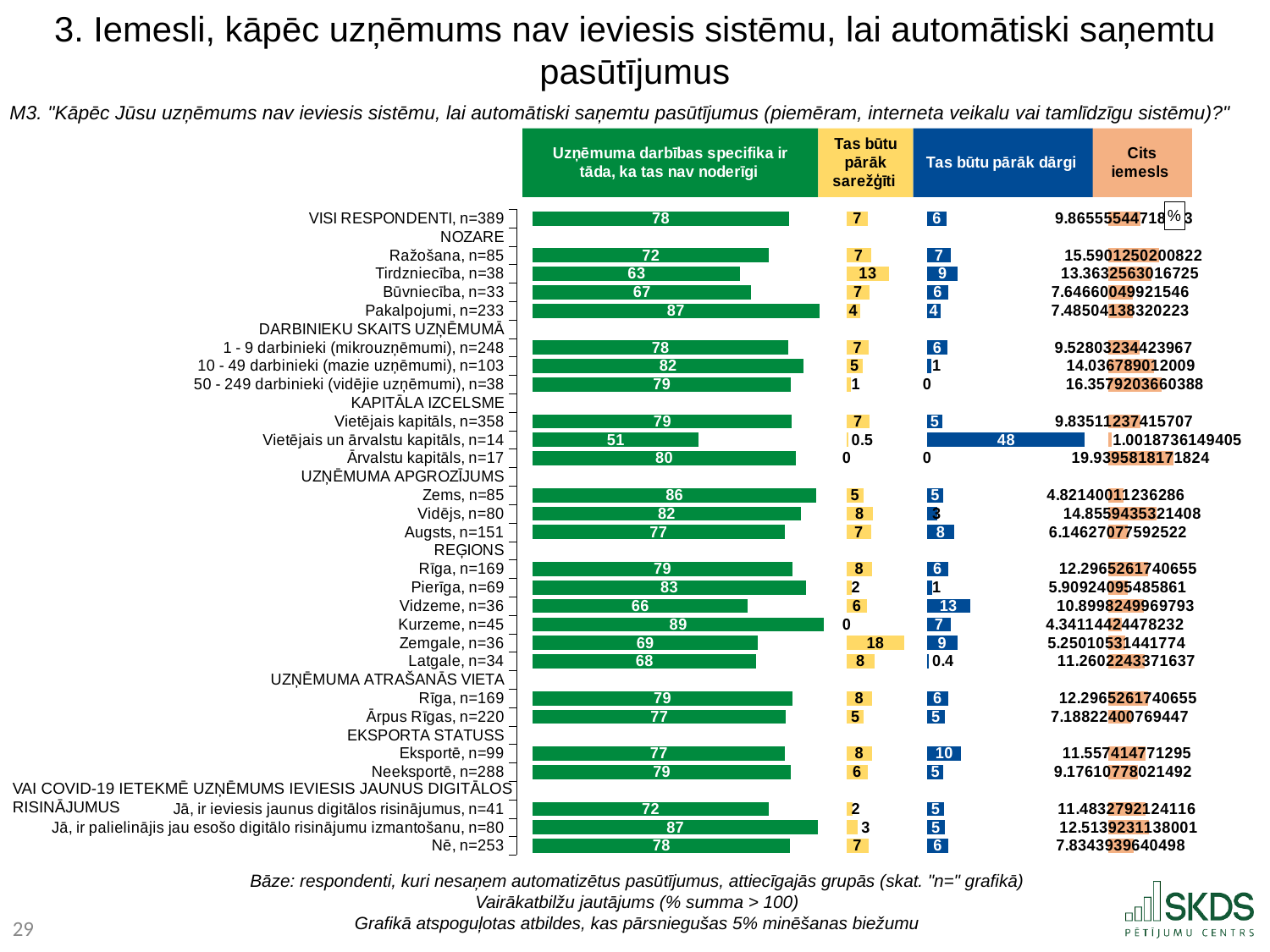
What colour are the bars for the series 'Tas būtu pārāk sarežģīti'? yellow Which has a larger value for 'Uzņēmuma darbības specifika ir tāda, ka tas nav noderīgi': Pakalpojumi, n=233 or Tirdzniecība, n=38? Pakalpojumi, n=233 What is the value for 'Uzņēmuma darbības specifika ir tāda, ka tas nav noderīgi' among VISI RESPONDENTI, n=389? 78 What kind of chart is shown on the slide? bar chart What is the value for 'Tas būtu pārāk sarežģīti' for Zemgale, n=36? 18 What is the difference between the 'Uzņēmuma darbības specifika ir tāda, ka tas nav noderīgi' values for Kurzeme, n=45 and Zemgale, n=36? 20 What is the value for 'Tas būtu pārāk dārgi' for Vietējais un ārvalstu kapitāls, n=14? 48 How many series (answer options) does the chart legend list? 4 Which group has the highest value for 'Uzņēmuma darbības specifika ir tāda, ka tas nav noderīgi'? Kurzeme, n=45 Which group has the highest value for 'Tas būtu pārāk sarežģīti'? Zemgale, n=36 What is the value for 'Tas būtu pārāk dārgi' for Vidzeme, n=36? 13 Which group has the lowest value for 'Uzņēmuma darbības specifika ir tāda, ka tas nav noderīgi'? Vietējais un ārvalstu kapitāls, n=14